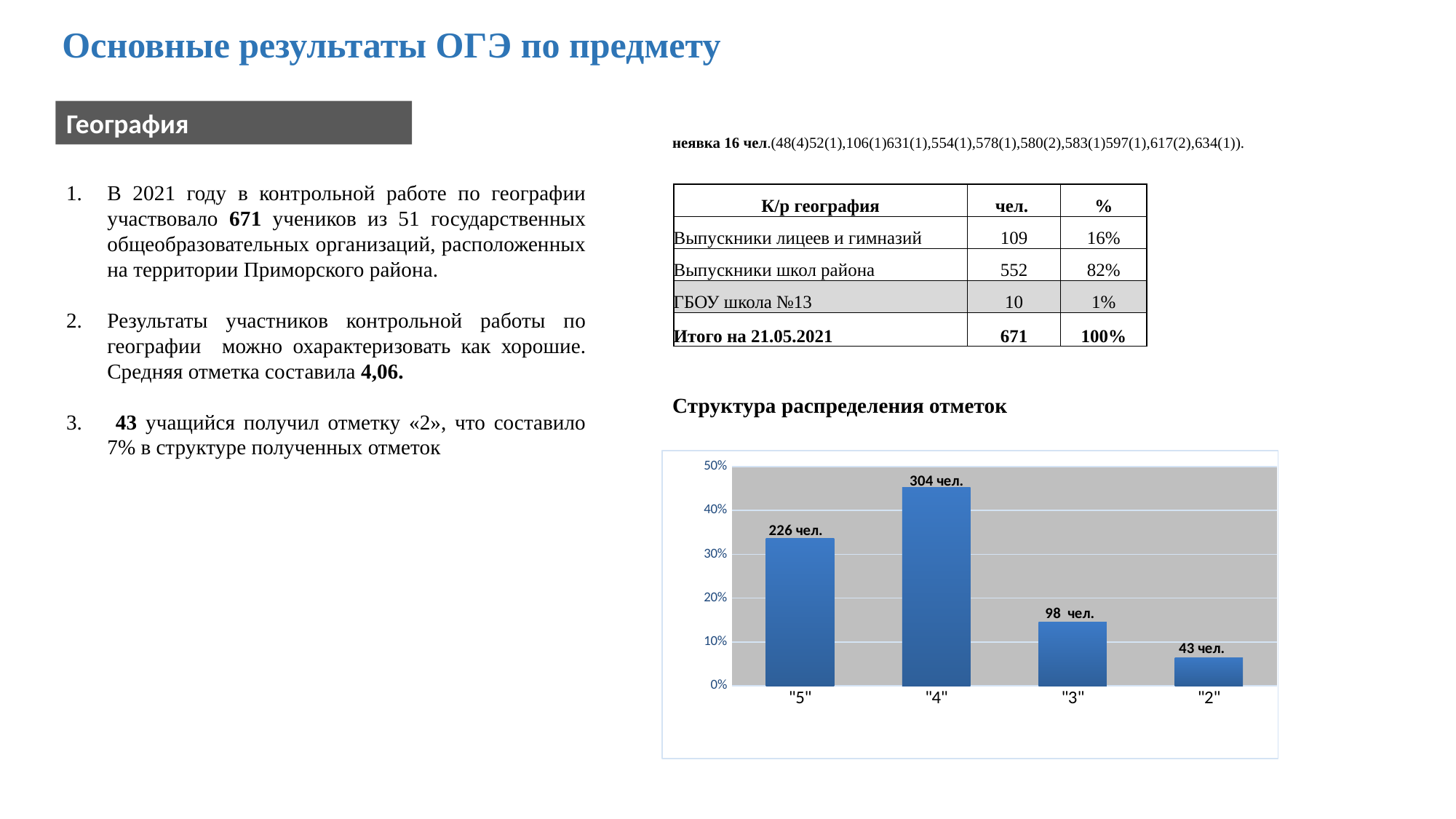
What is the title of the chart on the slide? Структура распределения отметок Which grade category has the tallest bar in the chart? "4" Is the value for "5" greater or less than 30% on the chart's axis? greater How many bars are shown in the chart? 4 What is the data label on the bar for "2" in the chart? 43 чел. Which bar is taller in the chart: "5" or "3"? "5" What is the data label on the bar for "4" in the chart "Структура распределения отметок"? 304 чел. By how many people does the "4" bar exceed the "5" bar, according to the data labels? 78 чел. Is the value for "2" greater or less than 10% on the chart's axis? less What type of chart is shown on the slide? Bar chart Which grade category has the shortest bar in the chart? "2" What is the data label on the bar for "3" in the chart? 98 чел.